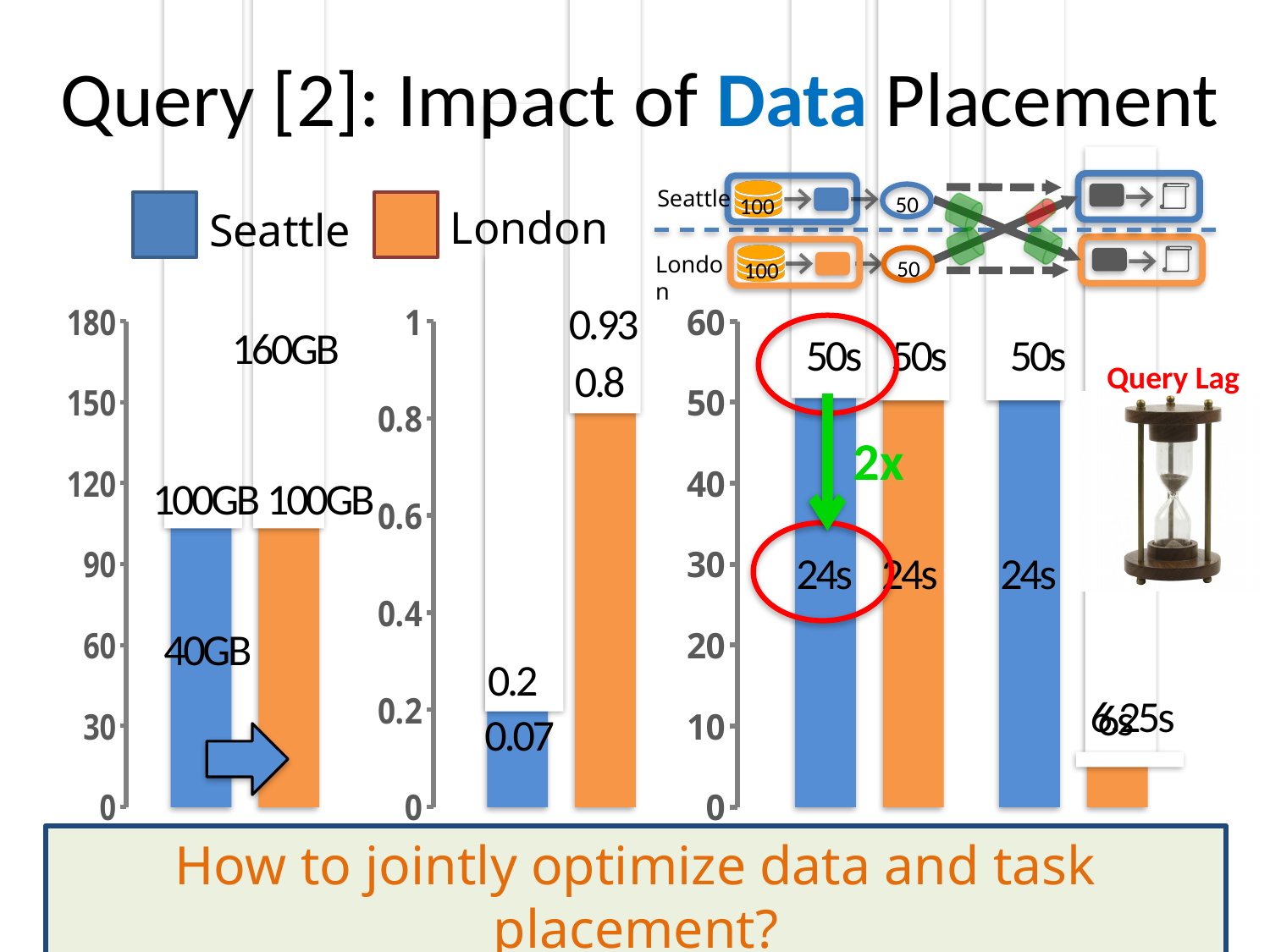
In the leftmost chart, is the value for the London bar greater or less than 90? greater In the middle chart (axis from 0 to 1), is the value for the London bar greater or less than 0.6? greater In the rightmost chart (axis from 0 to 60), is the value for the rightmost London bar greater or less than 10? less In the leftmost chart, what is the highest value shown on the vertical axis? 180 In the leftmost chart, what is the value labelled on the London bar? 100GB In the middle chart (axis from 0 to 1), which bar is taller, Seattle or London? London What kind of chart is the leftmost chart (with the GB axis)? Bar chart Which colour represents London in the legend? Orange How many series does the legend list? 2